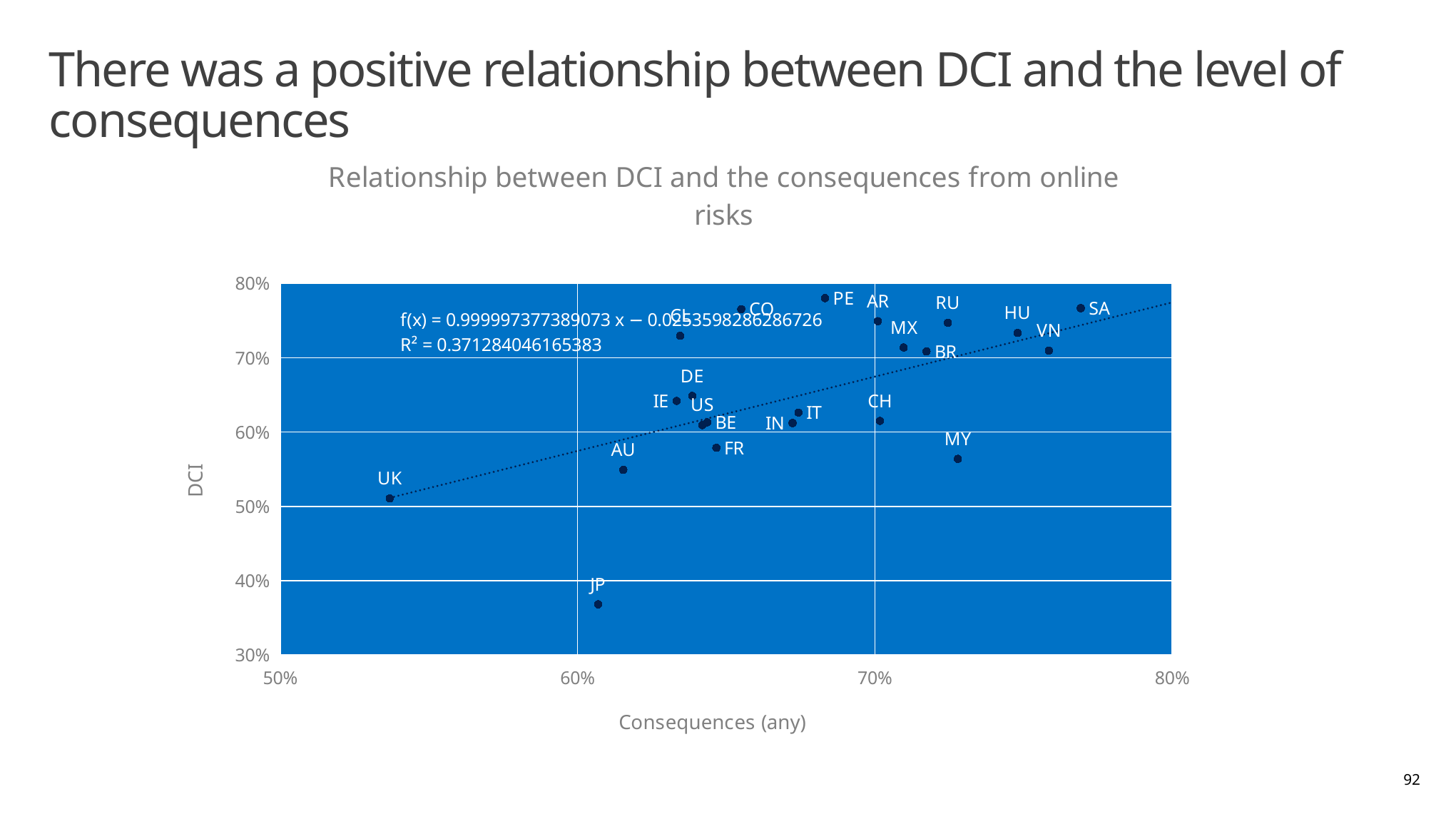
What is the R² value printed on the chart? 0.371284046165383 Which country has the highest DCI value? PE Which has a higher DCI value, RU or MY? RU Which country has the lowest value for Consequences (any)? UK Is the DCI value for JP greater or less than 40%? less Does DCI tend to rise or fall as Consequences (any) increases along the x axis? rise Is the DCI value for MY greater or less than 60%? less Which country has the lowest DCI value? JP Is the Consequences (any) value for SA greater or less than 70%? greater What kind of chart is shown on the slide? scatter chart